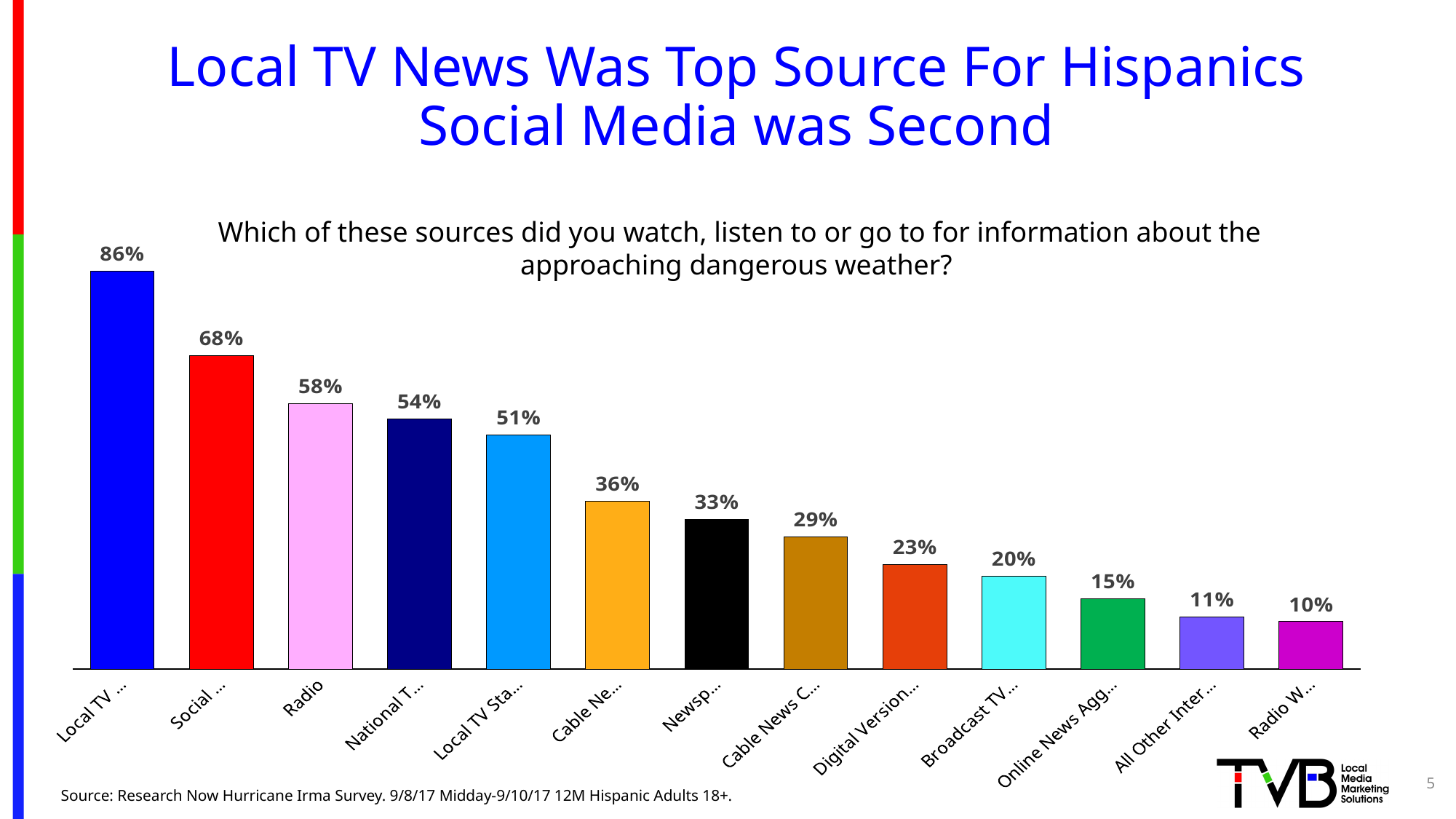
What is the value for Radio? 58% What is the difference between Radio and the fourth bar from the left (54%)? 4% What is the value of the first (leftmost) bar in the chart? 86% How many bars are plotted in the chart? 13 What is the value of the second bar from the left in the chart? 68% What is the difference between the first bar (86%) and the second bar (68%)? 18% What is the highest value shown in the chart? 86% Do the values rise or fall moving from left to right along the x axis? fall What question is shown as the chart's title? Which of these sources did you watch, listen to or go to for information about the approaching dangerous weather? What kind of chart is shown on the slide? bar chart What is the lowest value shown in the chart? 10% What is the value of the last (rightmost) bar in the chart? 10%